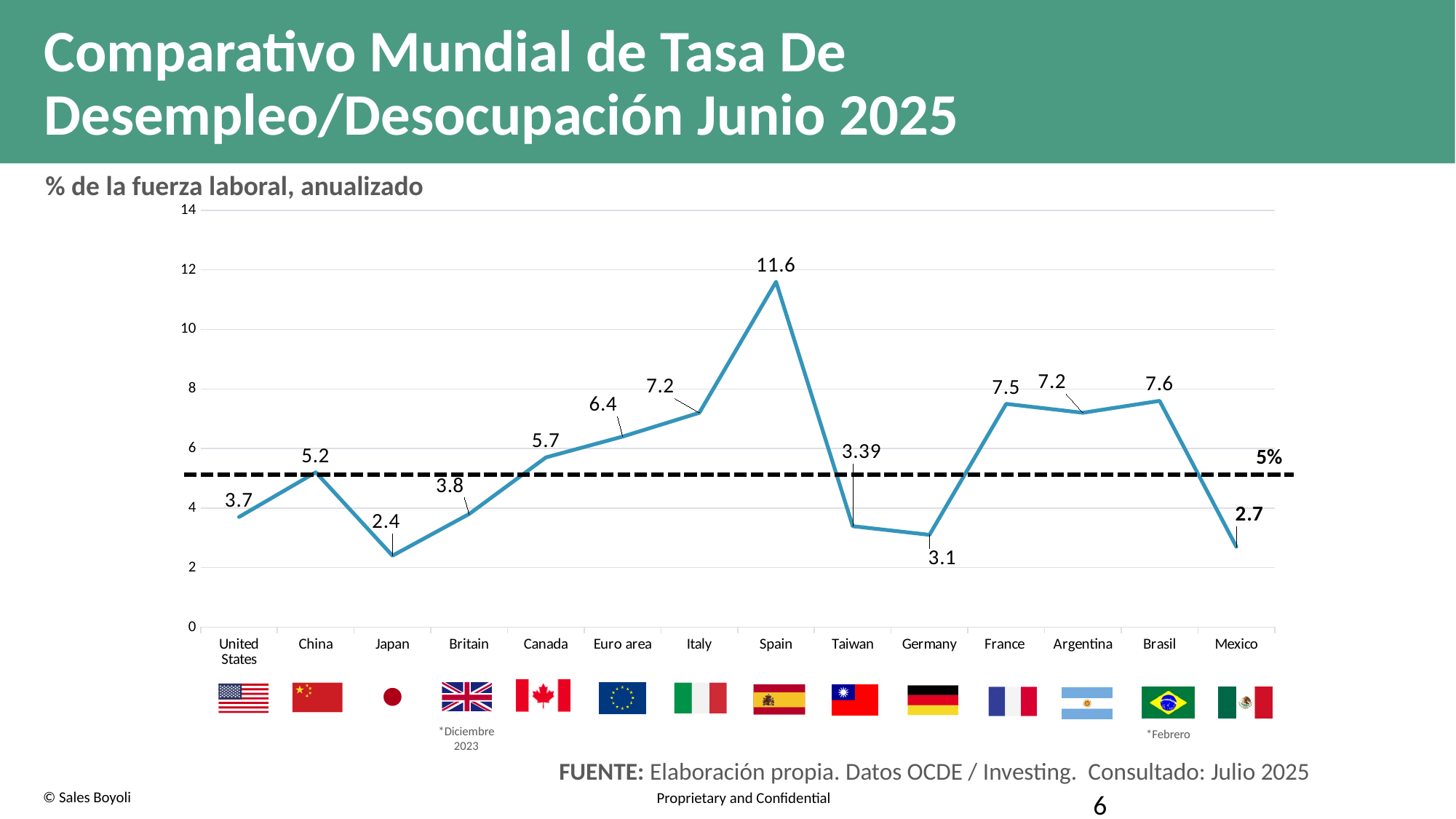
Which country has the lowest unemployment rate on the chart? Japan What is the unemployment rate shown for Spain? 11.6 How many countries or regions are plotted on the chart? 14 What is the unemployment rate shown for Taiwan? 3.39 What is the difference between the unemployment rates of Spain and Japan? 9.2 Is the value for Euro area greater or less than 6? greater Which has a higher unemployment rate, Canada or Britain? Canada What is the difference between the unemployment rates of Brasil and France? 0.1 What kind of chart is shown on the slide? Line chart Which country has the highest unemployment rate on the chart? Spain What value does the horizontal dashed reference line mark? 5% What is the unemployment rate shown for Mexico? 2.7